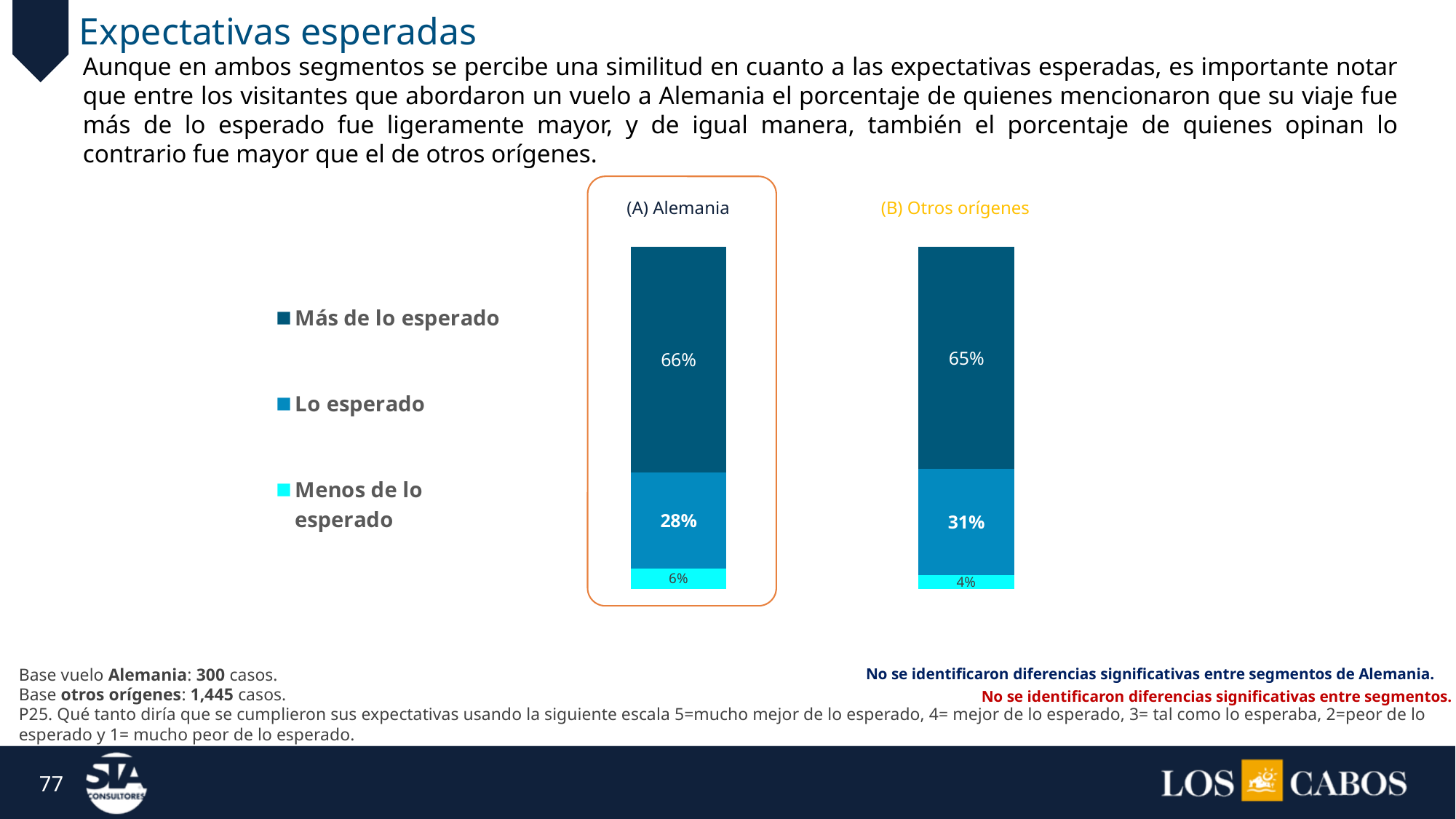
What is the difference between the "Menos de lo esperado" values for (A) Alemania and (B) Otros orígenes? 2% What is the value for "Más de lo esperado" in the (B) Otros orígenes bar? 65% What is the difference between the "Lo esperado" values for (B) Otros orígenes and (A) Alemania? 3% What kind of chart is shown on the slide? Stacked bar chart Which series has the lowest value in the (B) Otros orígenes bar? Menos de lo esperado How many series does the legend list? 3 What is the value for "Menos de lo esperado" in the (A) Alemania bar? 6% What percentage of (A) Alemania visitors said their trip was "Más de lo esperado"? 66% Which series has the highest value in the (A) Alemania bar? Más de lo esperado How many bars are shown in the chart? 2 What is the value for "Lo esperado" in the (B) Otros orígenes bar? 31% Which segment has the higher value for "Lo esperado", (A) Alemania or (B) Otros orígenes? (B) Otros orígenes